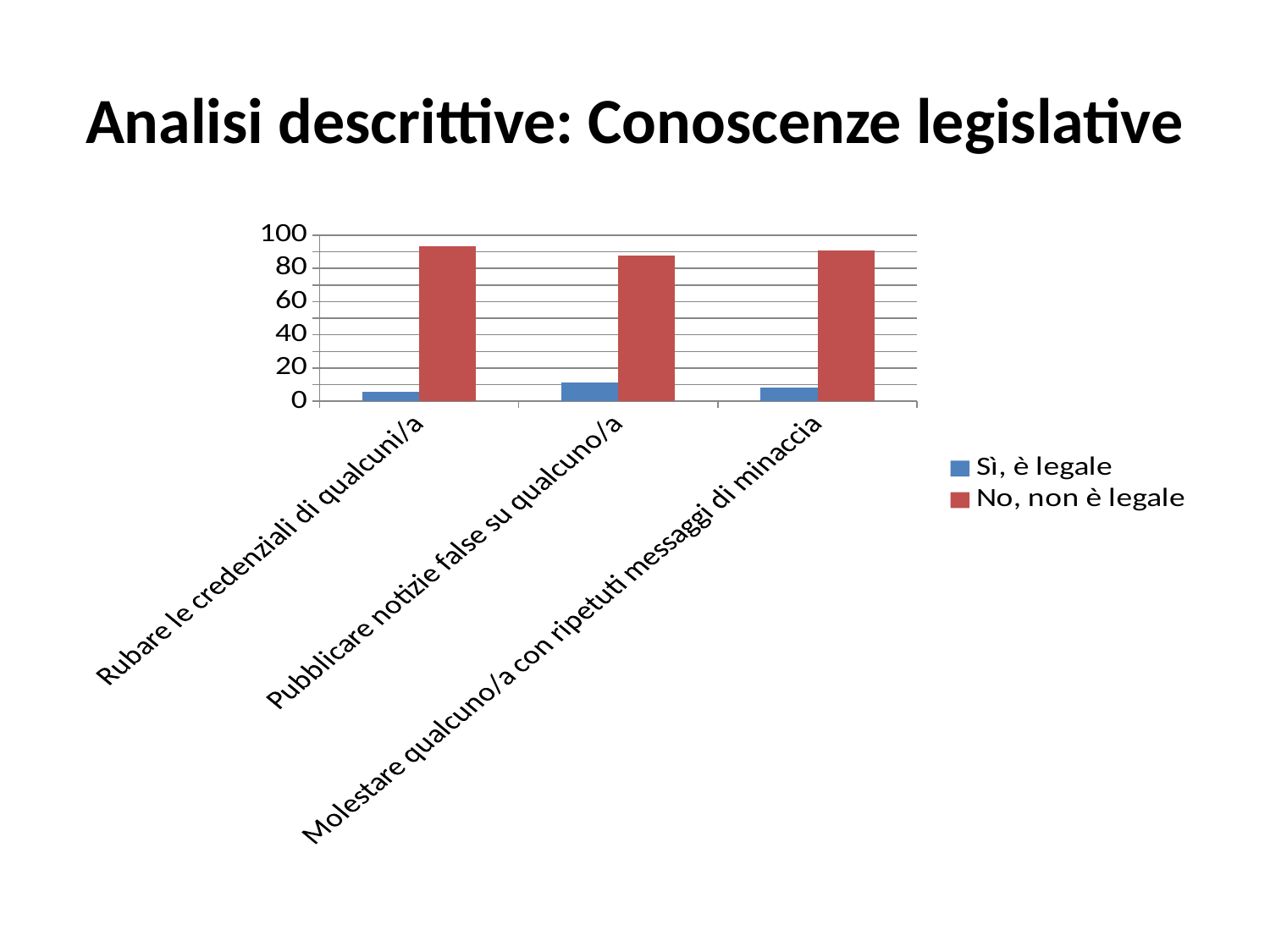
Is the value for "Sì, è legale" for "Pubblicare notizie false su qualcuno/a" greater or less than 20? less How many series does the chart's legend list? 2 Is the value for "No, non è legale" for "Rubare le credenziali di qualcuni/a" greater or less than 80? greater What is the title of the slide containing the chart? Analisi descrittive: Conoscenze legislative What is the highest value shown on the chart's vertical axis? 100 Is the value for "Sì, è legale" for "Rubare le credenziali di qualcuni/a" greater or less than 20? less Which is larger: the "Sì, è legale" value for "Rubare le credenziali di qualcuni/a" or the "Sì, è legale" value for "Pubblicare notizie false su qualcuno/a"? Pubblicare notizie false su qualcuno/a For "Pubblicare notizie false su qualcuno/a", which series has the larger value: "Sì, è legale" or "No, non è legale"? No, non è legale How many categories are shown on the x axis of the chart? 3 Which series is shown in red in the chart? No, non è legale What kind of chart is shown on the slide? bar chart